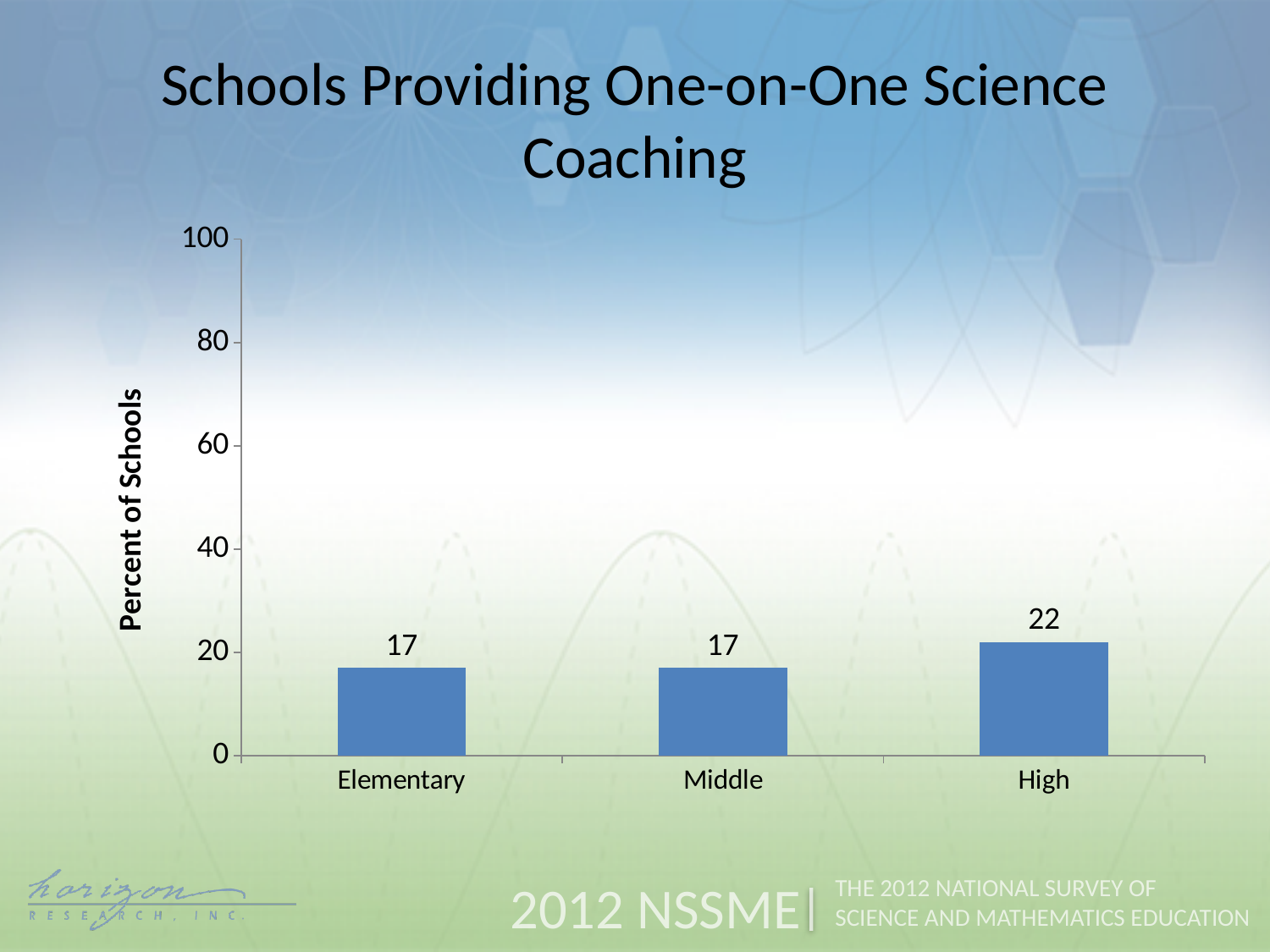
What is the value for High schools? 22 What is the label of the vertical axis? Percent of Schools Is the value for High schools greater or less than 40? less How many school levels are shown on the chart? 3 What percent of elementary schools provide one-on-one science coaching? 17 Which school level has the highest percent of schools providing one-on-one science coaching? High Which is larger, the value for High or the value for Middle? High What is the title of the chart? Schools Providing One-on-One Science Coaching What kind of chart is shown on the slide? Bar chart What is the difference between the values for High and Elementary schools? 5 Do the values for Elementary and Middle schools differ? No, both are 17 What is the value for Middle schools? 17